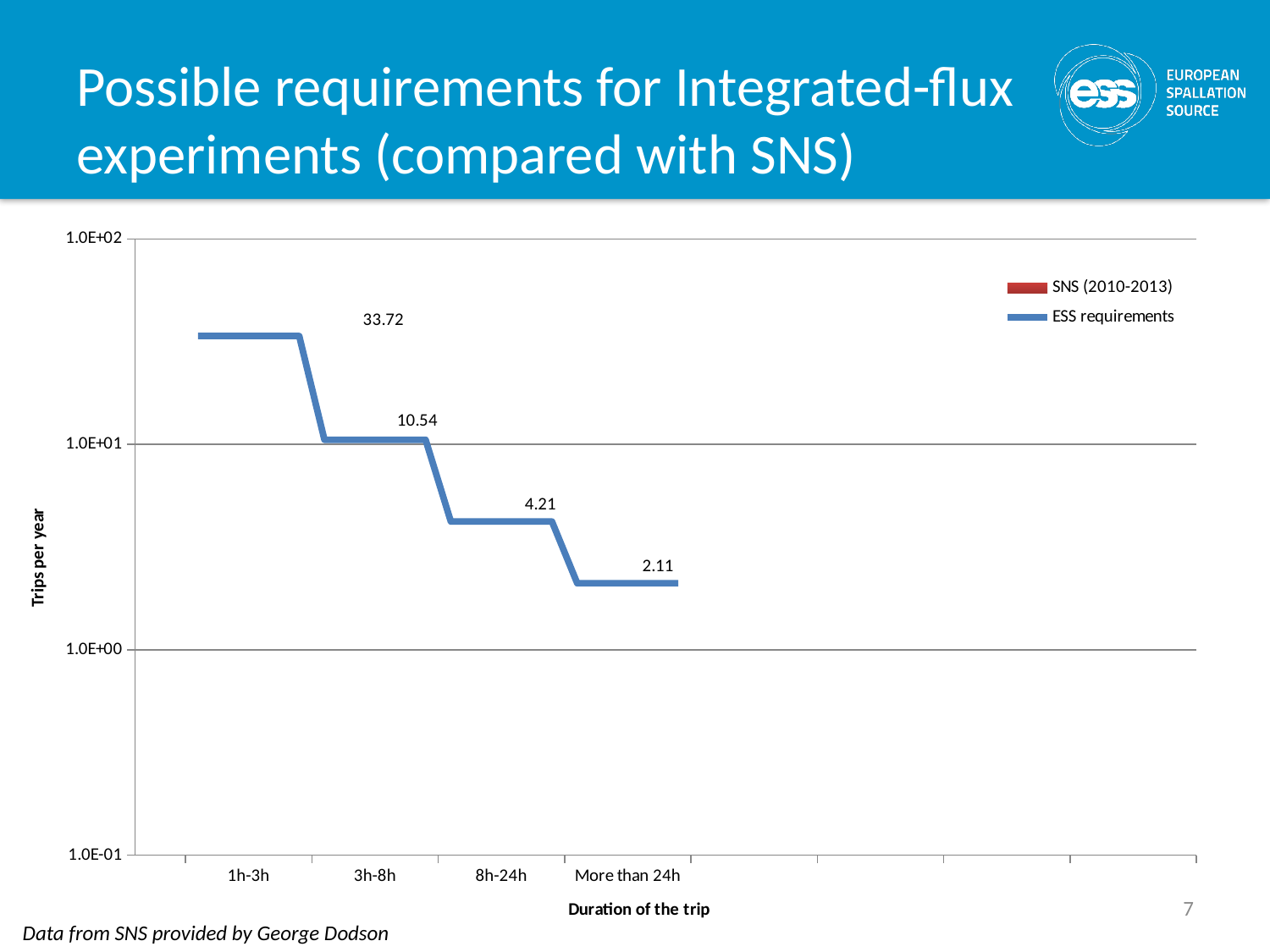
What is the ESS requirements value for trips lasting 1h-3h? 33.72 Which trip duration category has the highest ESS requirements value? 1h-3h What is the label of the y axis? Trips per year Do the ESS requirements values rise or fall as trip duration increases along the x axis? fall What is the ESS requirements value for trips lasting 3h-8h? 10.54 What is the ESS requirements value for trips lasting more than 24h? 2.11 How many trip duration categories are labelled on the x axis? 4 How many series does the legend list? 2 What is the difference between the ESS requirements values for 1h-3h and 3h-8h? 23.18 What is the ESS requirements value for trips lasting 8h-24h? 4.21 Which trip duration category has the lowest ESS requirements value? More than 24h Which is larger, the ESS requirements value for 8h-24h or for more than 24h? 8h-24h